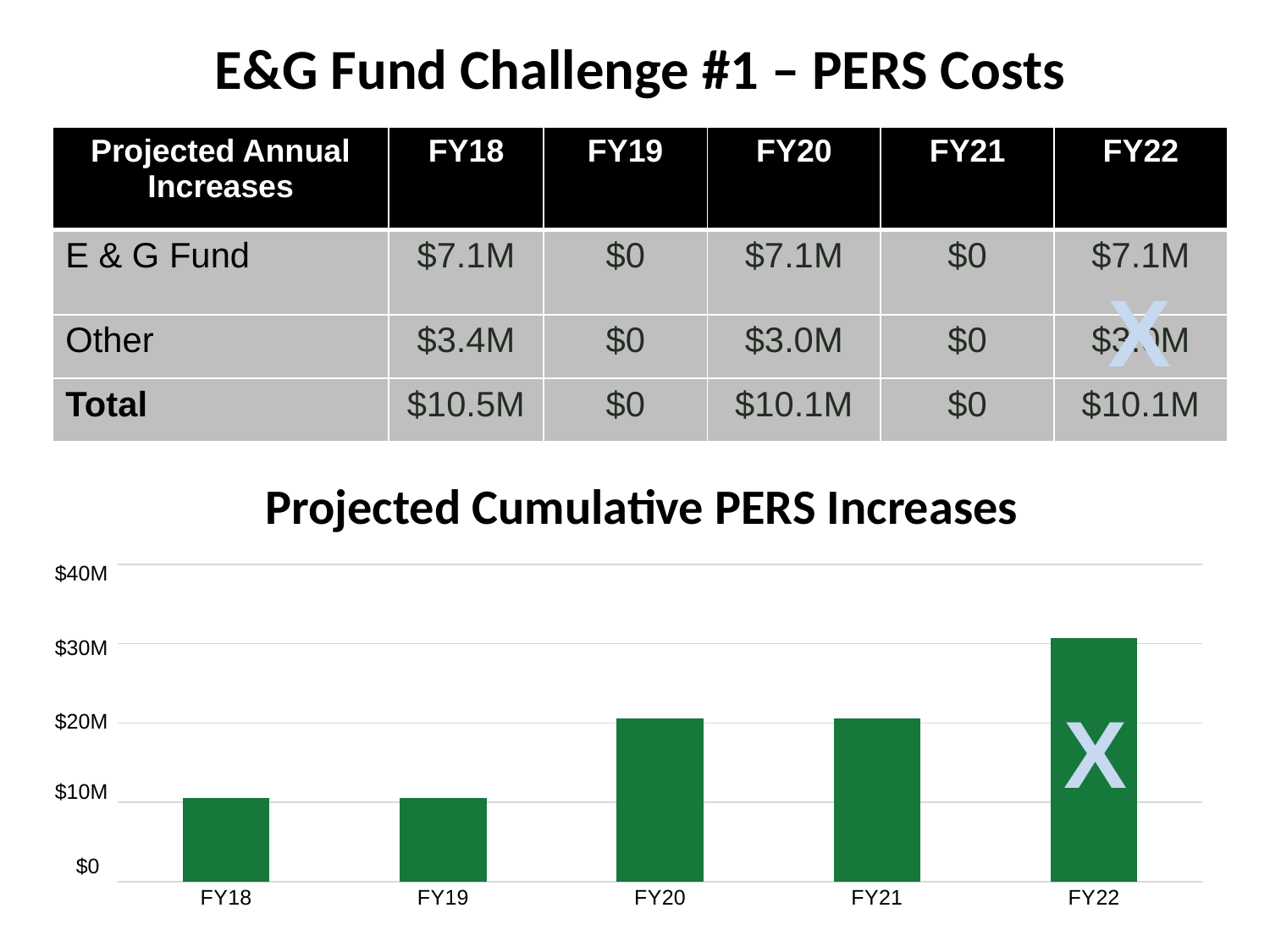
What colour are the bars in the chart? green Is the value for FY22 greater or less than $40M? less Is the value for FY20 greater or less than $10M? greater Which is larger in the chart, the bar for FY20 or the bar for FY18? FY20 Is the value for FY21 greater or less than $30M? less How many fiscal years are plotted on the x axis of the chart? 5 Do the bars in the chart generally rise or fall from FY18 to FY22? rise What type of chart is shown under the heading "Projected Cumulative PERS Increases"? bar chart What is the title of the chart on the slide? Projected Cumulative PERS Increases Which fiscal year has the highest bar in the chart? FY22